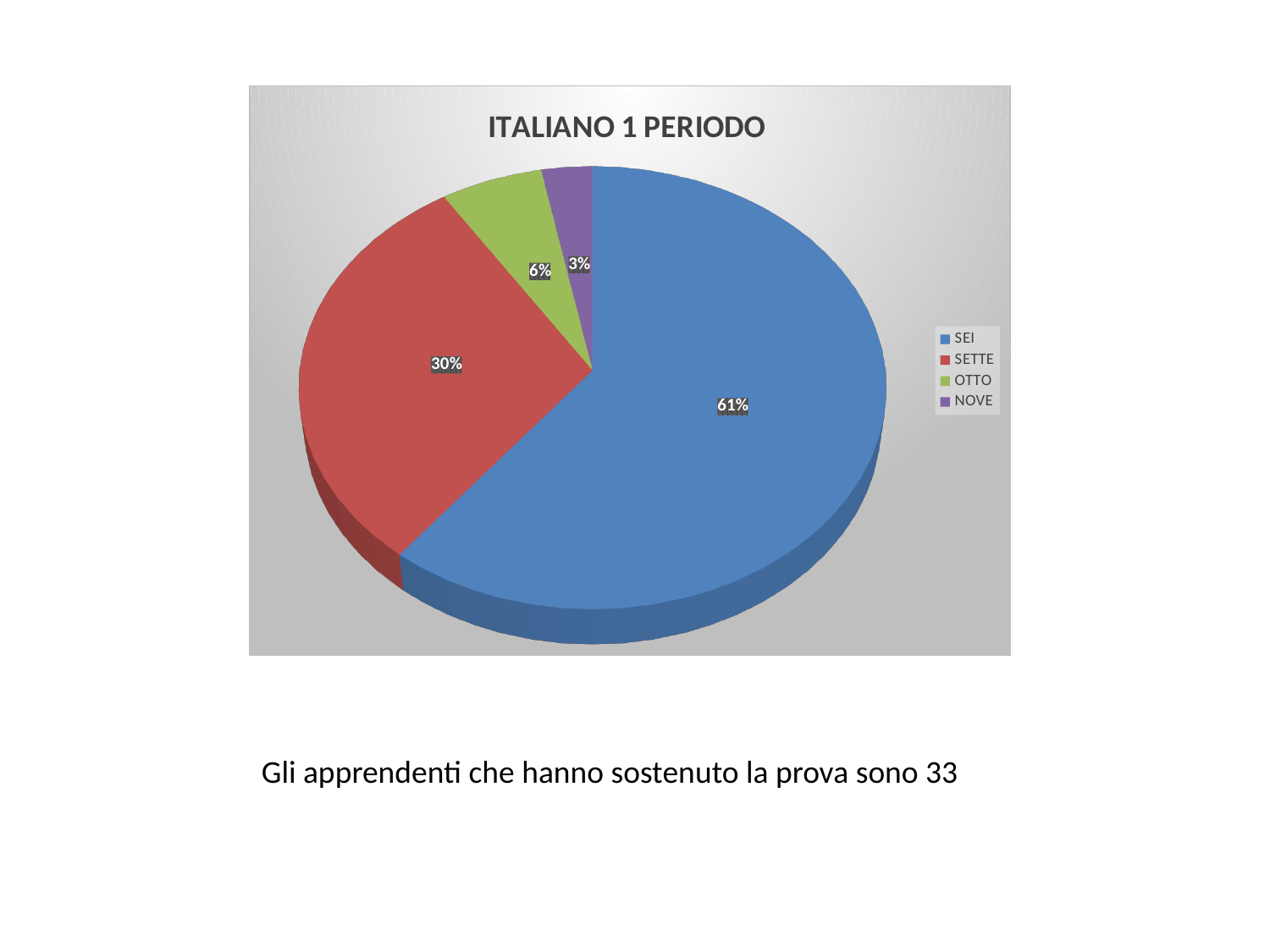
What share of the pie does SETTE represent? 30% Which category has the smallest slice of the pie? NOVE What colour is the slice for SETTE? red What share of the pie does NOVE represent? 3% How many categories does the legend list? 4 What share of the pie does SEI represent? 61% Which category has the largest slice of the pie? SEI What is the title of the chart? ITALIANO 1 PERIODO What kind of chart is shown on the slide? pie chart Which is larger, the share for OTTO or the share for NOVE? OTTO What is the difference in percentage points between SEI and SETTE? 31